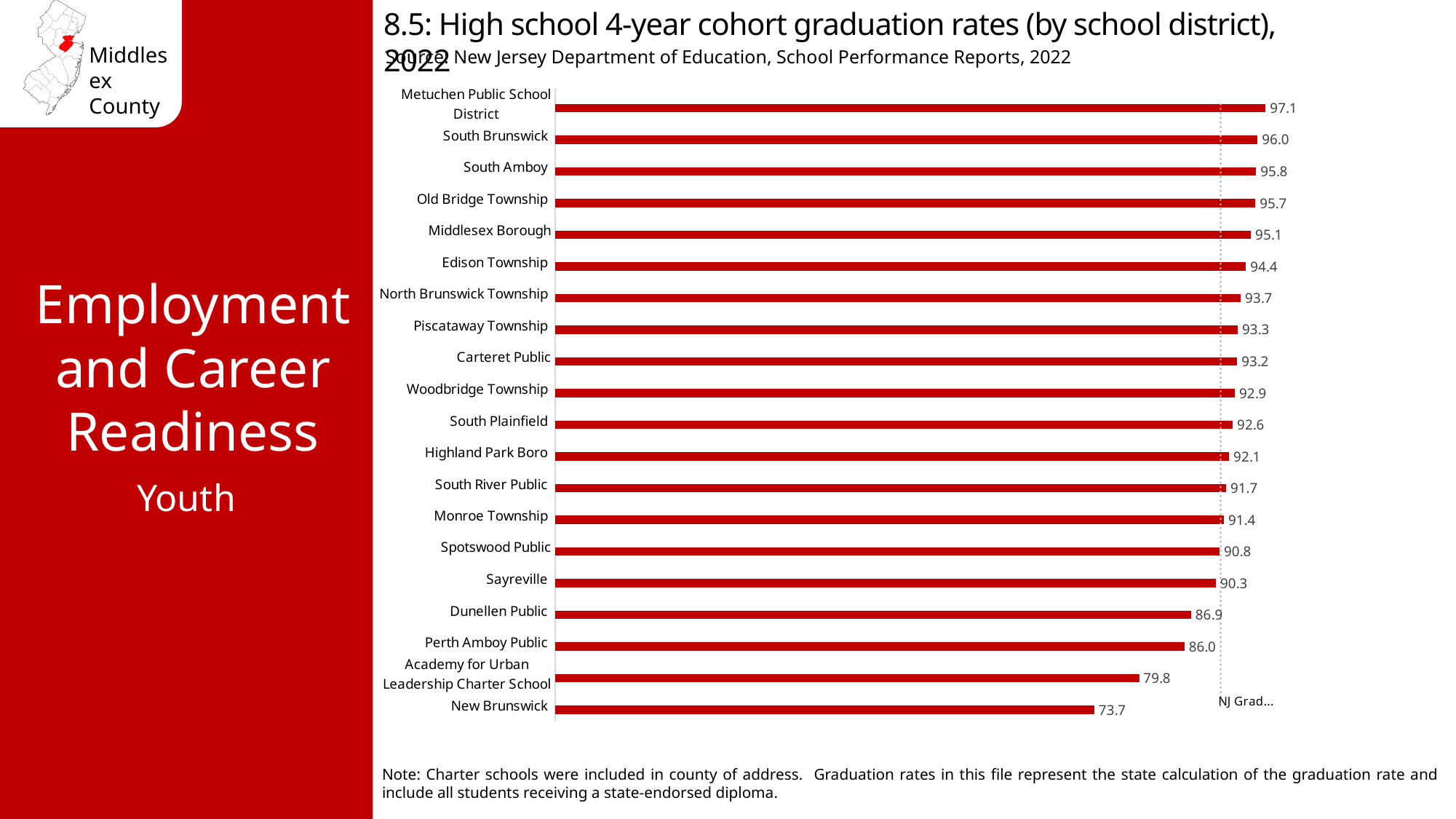
Which has a higher graduation rate, Sayreville or Academy for Urban Leadership Charter School? Sayreville What is the 4-year cohort graduation rate for Metuchen Public School District? 97.1 Which has a higher graduation rate, South Brunswick or Woodbridge Township? South Brunswick How many school districts are shown on the chart? 20 What is the difference between the graduation rates of Dunellen Public and Perth Amboy Public? 0.9 What is the graduation rate shown for Edison Township? 94.4 What kind of chart is used to show the graduation rates? Bar chart Which school district has the highest graduation rate on the chart? Metuchen Public School District What is the difference between the graduation rates of Metuchen Public School District and New Brunswick? 23.4 Which school district has the lowest graduation rate on the chart? New Brunswick What is the graduation rate shown for Perth Amboy Public? 86.0 What is the source cited for the graduation rate data? New Jersey Department of Education, School Performance Reports, 2022